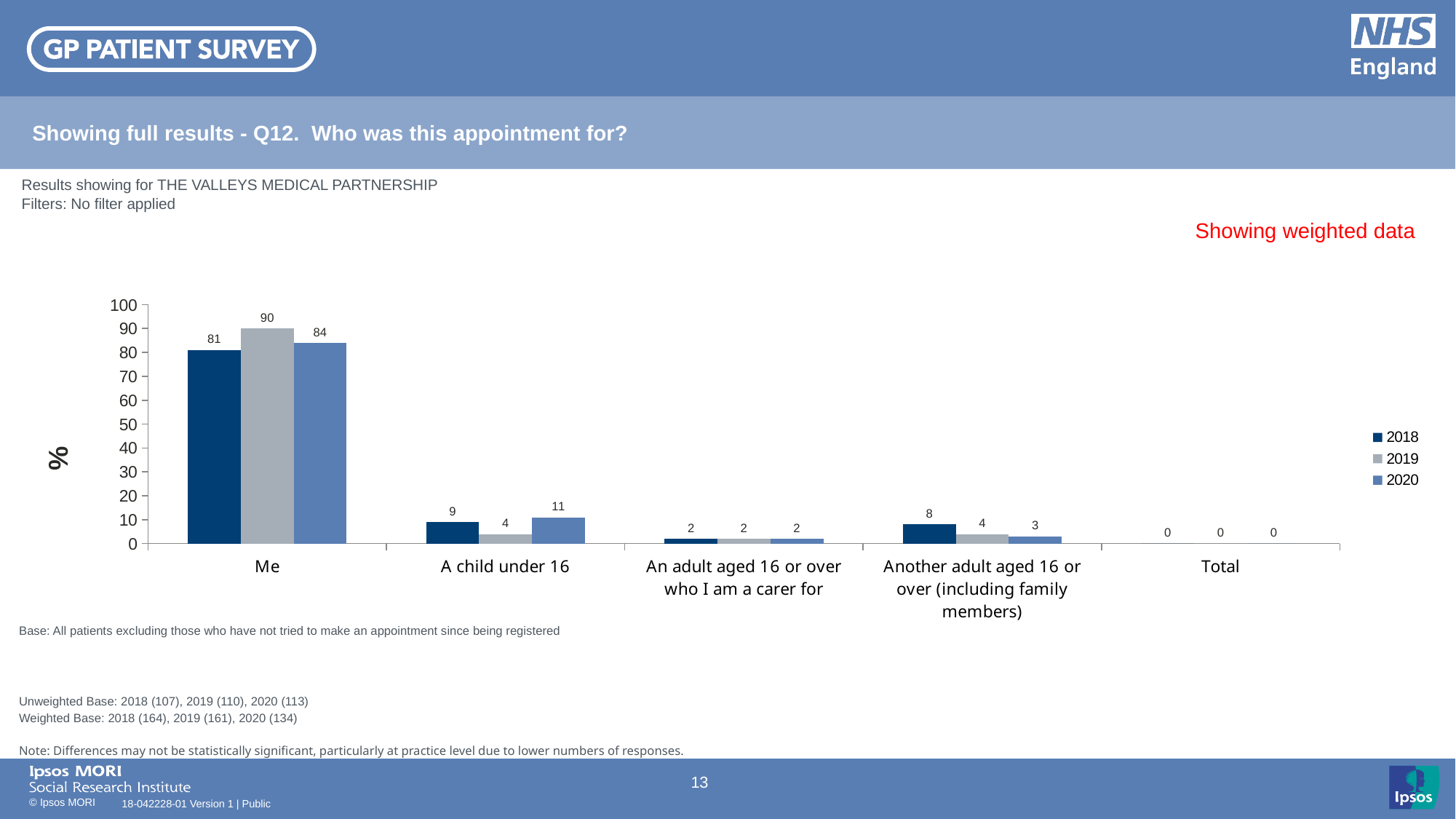
Is the 2020 value for 'Me' greater or less than 50? greater What is the value for 'Me' in 2019? 90 How many categories are shown on the x axis? 5 What kind of chart is shown on the slide? bar chart Which is larger: the 2018 value for 'A child under 16' or the 2018 value for 'Another adult aged 16 or over (including family members)'? A child under 16 What is the value for 'Another adult aged 16 or over (including family members)' in 2018? 8 What is the value for 'An adult aged 16 or over who I am a carer for' in 2020? 2 How many series does the legend list? 3 Which year has the highest value for 'Me'? 2019 Which year has the lowest value for 'A child under 16'? 2019 What is the value for 'A child under 16' in 2020? 11 What is the difference between the 2019 and 2018 values for 'Me'? 9